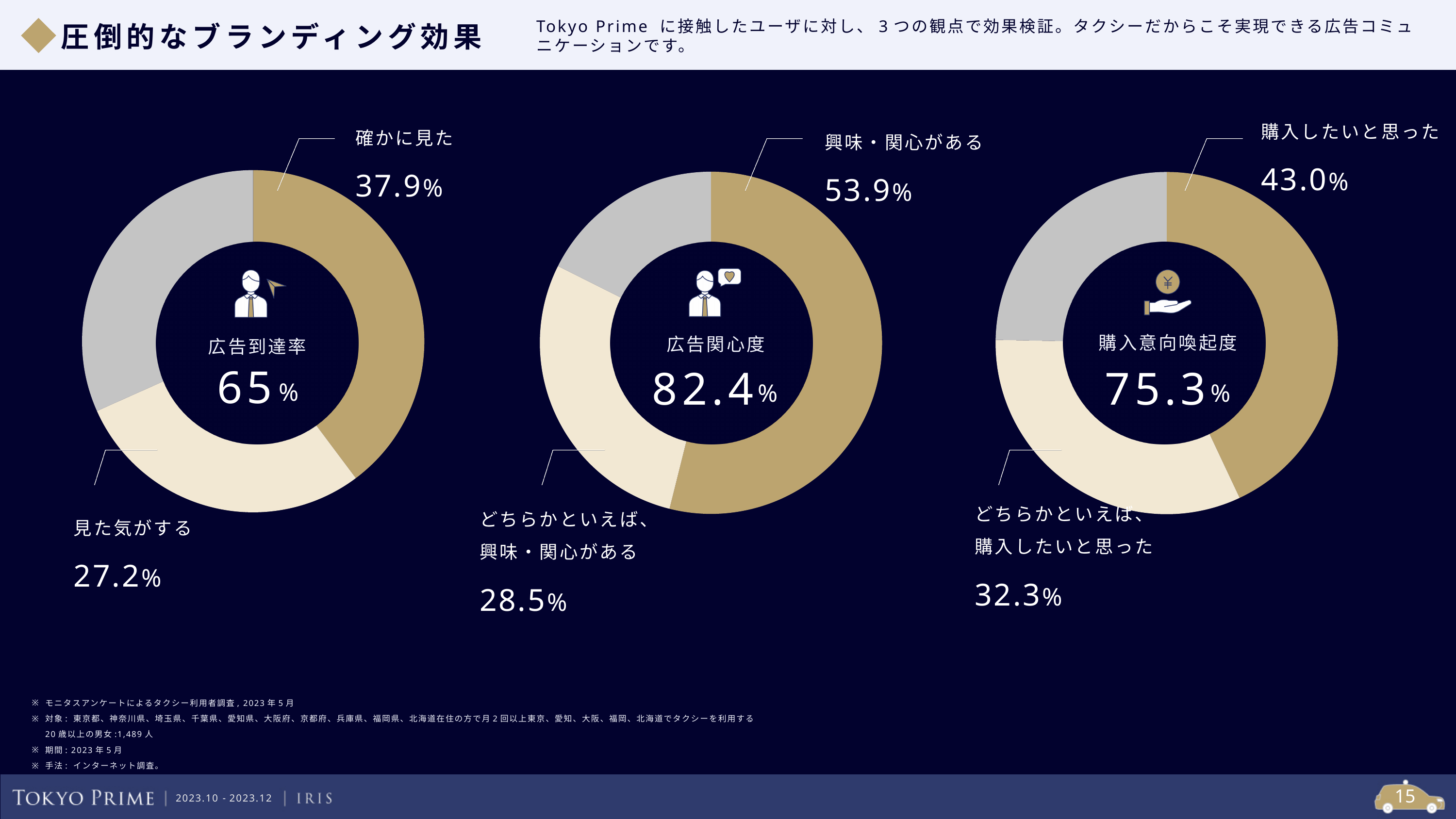
Which of the three charts shows the highest overall percentage in its center? 広告関心度 (82.4%) In the 購入意向喚起度 chart (right), what is the combined share of 購入したいと思った and どちらかといえば、購入したいと思った? 75.3% In the 広告到達率 chart (left), which is larger, 確かに見た or 見た気がする? 確かに見た In the 広告関心度 chart (middle), what percentage is shown for どちらかといえば、興味・関心がある? 28.5% In the 広告関心度 chart (middle), how much larger is 興味・関心がある than どちらかといえば、興味・関心がある? 25.4% In the 広告関心度 chart (middle), what percentage is shown for 興味・関心がある? 53.9% In the 購入意向喚起度 chart (right), what percentage is shown for 購入したいと思った? 43.0% In the 広告到達率 chart (left), what percentage is shown for 見た気がする? 27.2% In the 購入意向喚起度 chart (right), what percentage is shown for どちらかといえば、購入したいと思った? 32.3% In the 広告関心度 chart (middle), what is the combined share of 興味・関心がある and どちらかといえば、興味・関心がある? 82.4% In the 広告到達率 chart (left), what percentage is shown for 確かに見た? 37.9% What type of chart is used for the three metrics on this slide? Donut (pie) chart